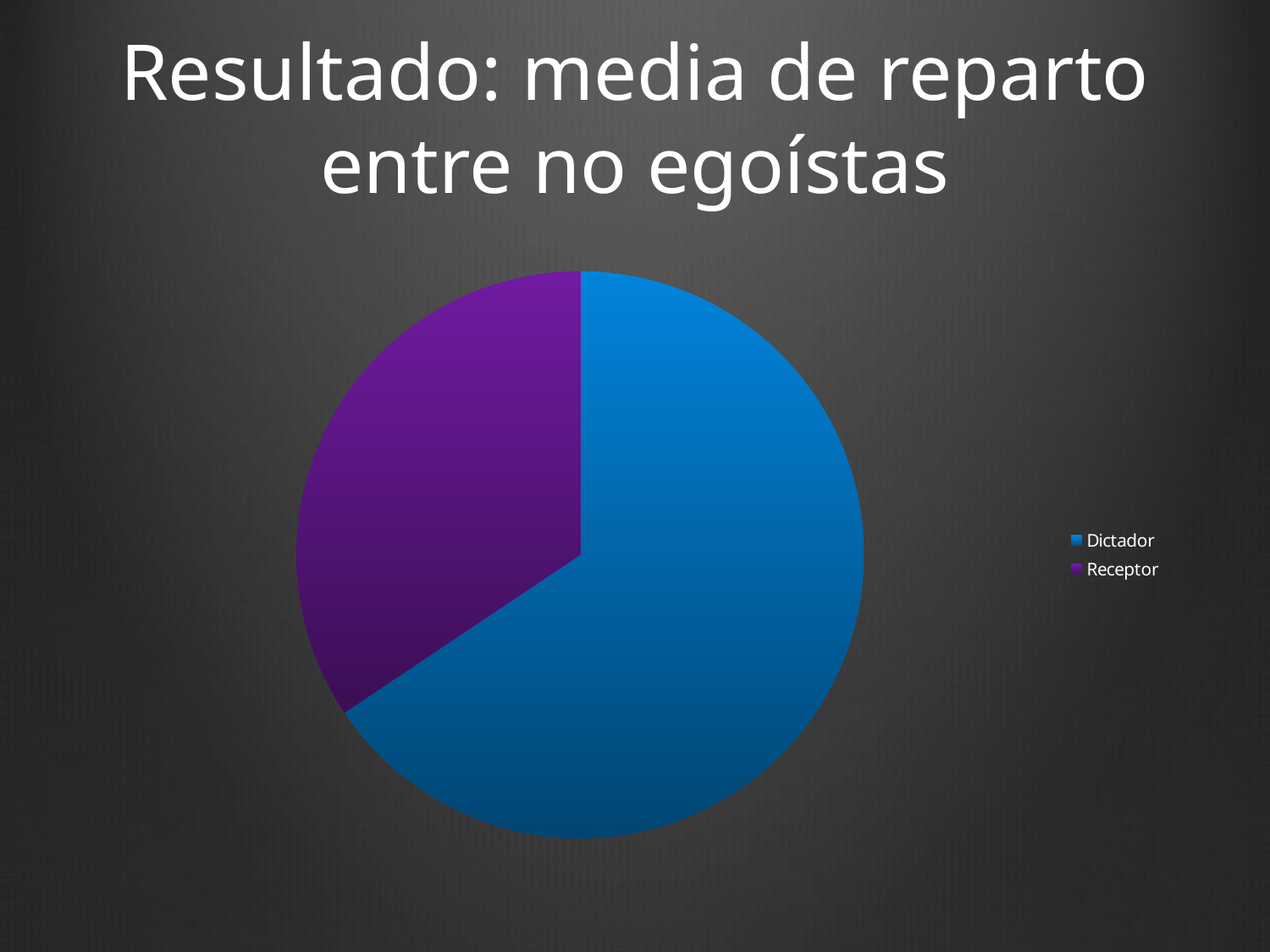
Which category has the smallest slice of the pie? Receptor What kind of chart is shown on the slide? Pie chart How many entries does the legend list? 2 What colour is the Receptor slice in the pie chart? Purple How many slices does the pie chart have? 2 What is the title of the slide containing the chart? Resultado: media de reparto entre no egoístas Which category has the largest slice of the pie? Dictador Which slice is larger, Dictador or Receptor? Dictador